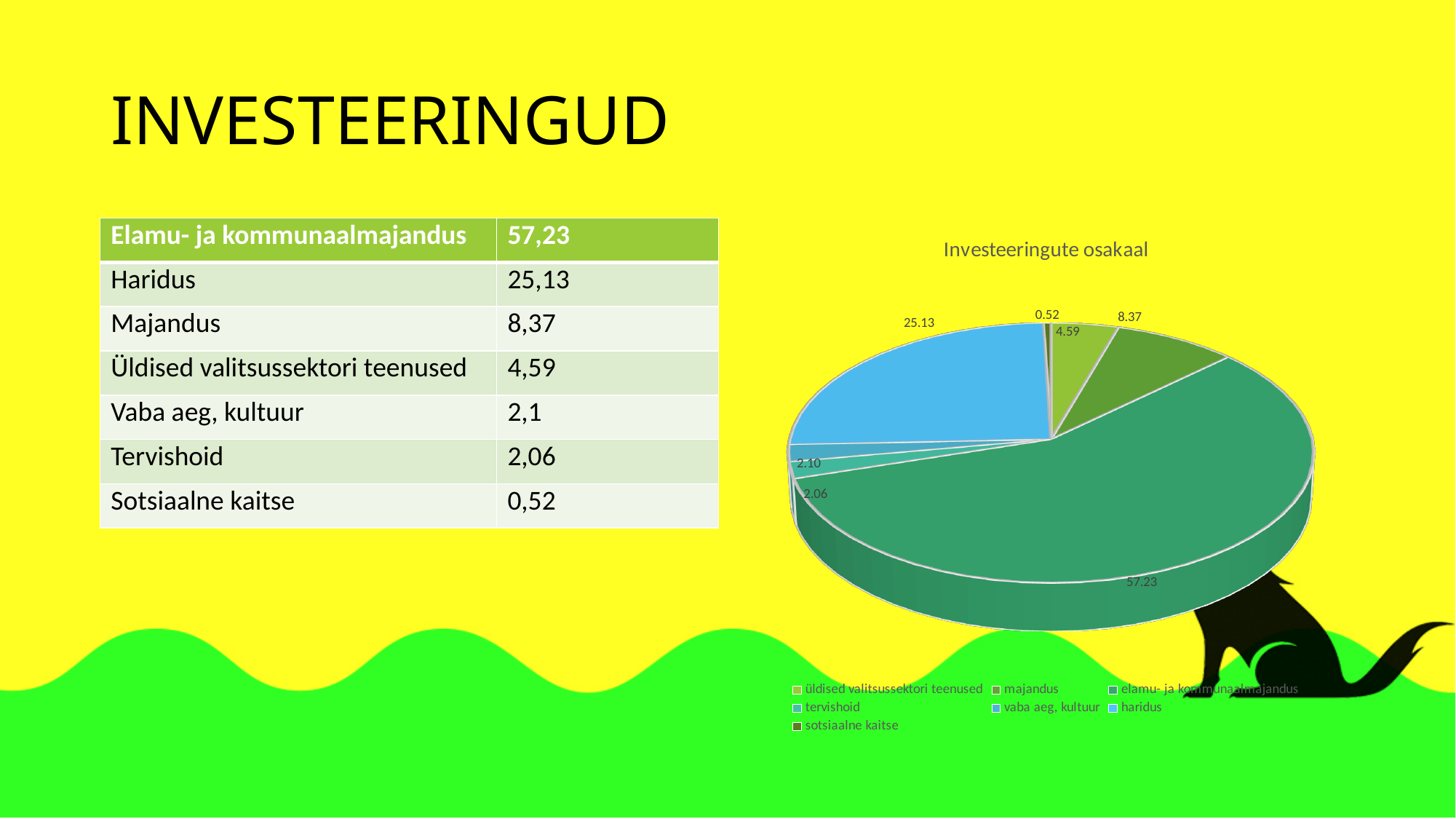
How many slices does the pie chart have? 7 Which category has the smallest slice in the pie chart? sotsiaalne kaitse What is the difference between the labelled values for elamu- ja kommunaalmajandus and haridus in the pie chart? 32.10 Which category has the largest slice in the pie chart? elamu- ja kommunaalmajandus In the pie chart, which is larger: the slice for haridus or the slice for majandus? haridus What value is labelled on the pie chart for haridus? 25.13 What kind of chart is shown under the title "Investeeringute osakaal"? pie chart What is the title of the pie chart? Investeeringute osakaal What value is labelled on the pie chart for majandus? 8.37 What value is labelled on the pie chart for elamu- ja kommunaalmajandus? 57.23 How many entries does the legend of the pie chart list? 7 What value is labelled on the pie chart for sotsiaalne kaitse? 0.52